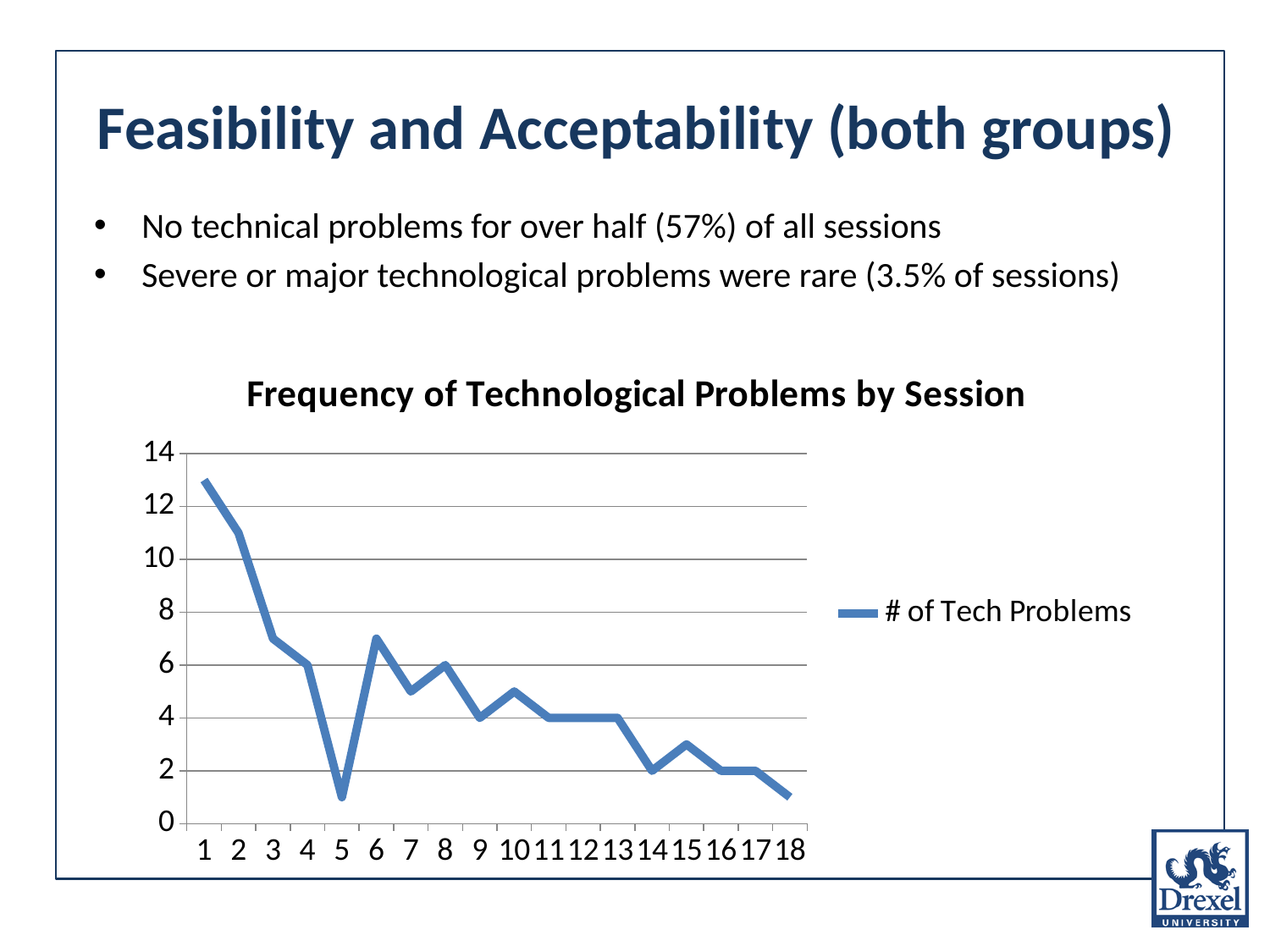
What type of chart is shown on the slide? Line chart Is the value for session 5 greater or less than 2? less Is the value for session 6 greater or less than 6? greater Which session has the highest number of tech problems? 1 What is the title of the chart? Frequency of Technological Problems by Session What is the name of the series shown in the legend? # of Tech Problems Overall, do the values rise or fall from session 1 to session 18? Fall Which has more tech problems, session 1 or session 18? Session 1 Which has more tech problems, session 6 or session 5? Session 6 How many sessions are plotted along the x axis? 18 Is the value for session 1 greater or less than 12? greater How many series does the chart's legend list? 1